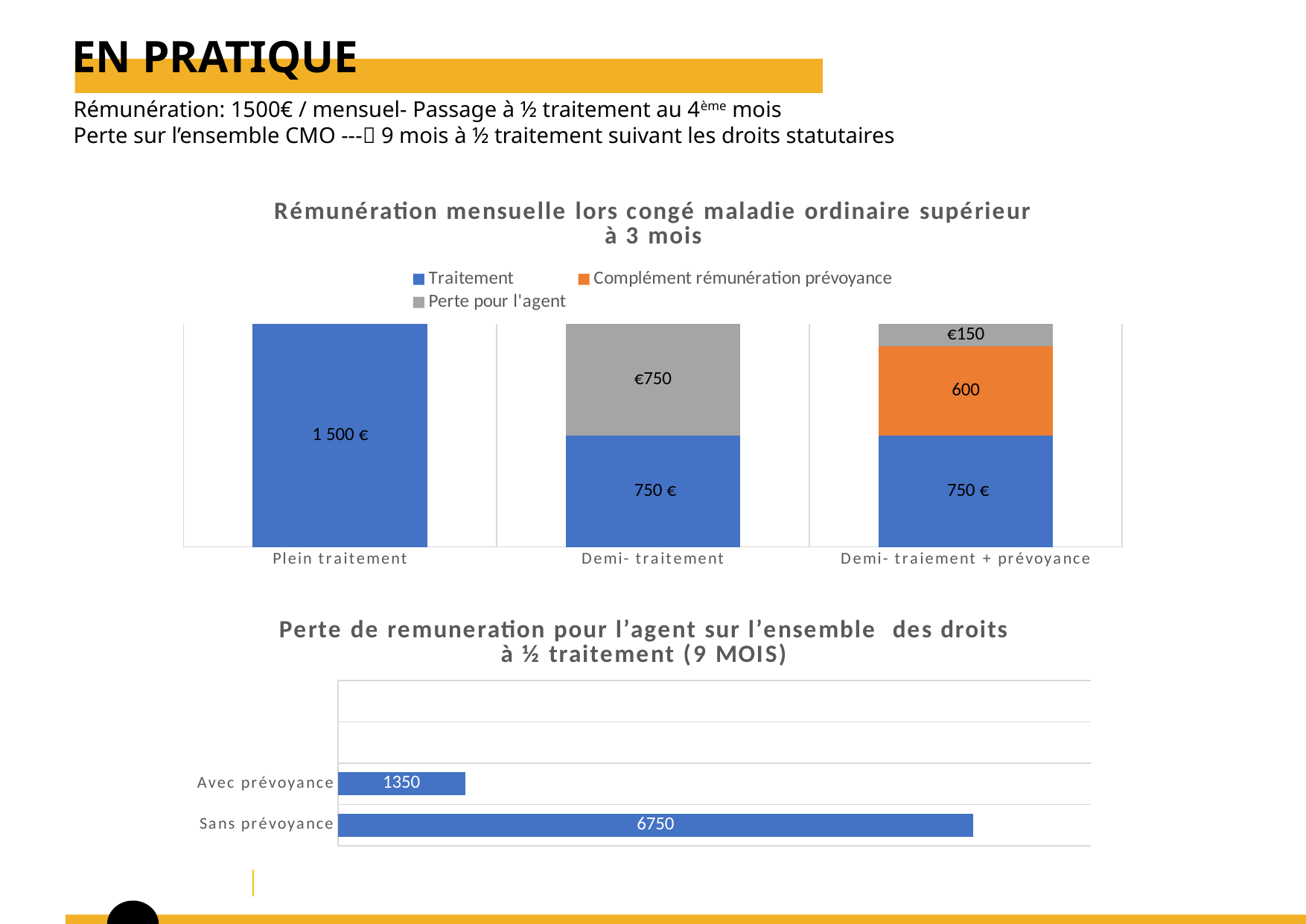
What kind of chart is the bottom chart? Bar chart In the top chart, which legend entry is shown in orange? Complément rémunération prévoyance In the bottom chart, what is the difference between Sans prévoyance and Avec prévoyance? 5400 In the top chart, what is the Traitement value for Plein traitement? 1 500 € In the bottom chart, what is the value for Sans prévoyance? 6750 In the top chart, what is the total of the stacked bar for Demi- traiement + prévoyance? 1500 In the bottom chart, what is the value for Avec prévoyance? 1350 In the top chart, what is the Perte pour l'agent value for Demi- traiement + prévoyance? €150 How many series does the legend of the top chart list? 3 How many categories are shown on the x axis of the top chart? 3 In the top chart, what is the Perte pour l'agent value for Demi- traitement? €750 In the top chart, what is the Complément rémunération prévoyance value for Demi- traiement + prévoyance? 600